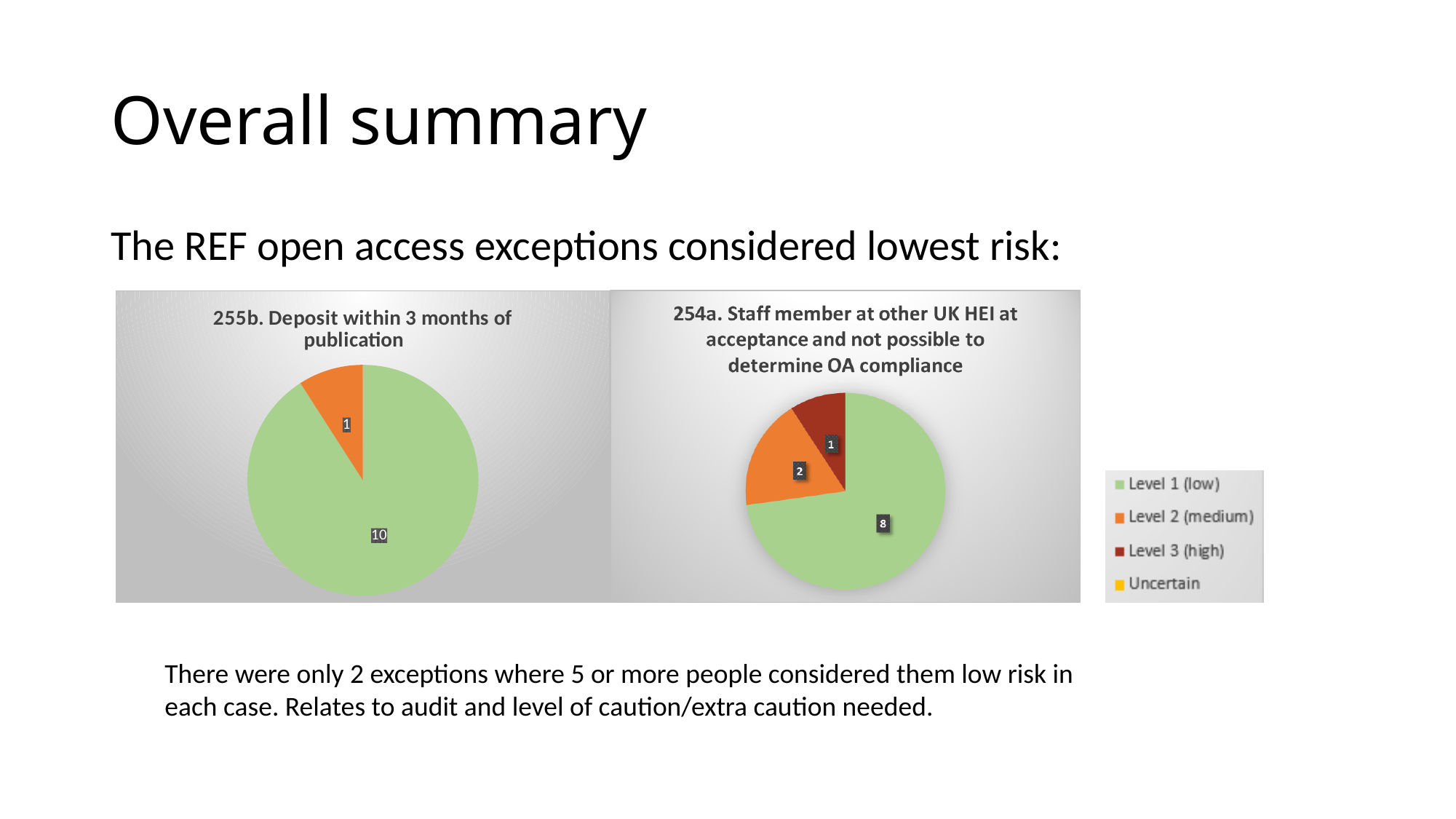
What kind of chart is used for "255b. Deposit within 3 months of publication"? Pie chart In the chart titled "255b. Deposit within 3 months of publication", what is the value for Level 2 (medium)? 1 In the chart titled "254a. Staff member at other UK HEI at acceptance and not possible to determine OA compliance", what is the value for Level 3 (high)? 1 Which chart has the larger Level 2 (medium) value, the left-hand chart (255b) or the right-hand chart (254a)? The right-hand chart (254a) In the chart titled "254a. Staff member at other UK HEI at acceptance and not possible to determine OA compliance", what is the value for Level 2 (medium)? 2 In the right-hand chart (254a), which risk level has the largest slice? Level 1 (low) In the chart titled "254a. Staff member at other UK HEI at acceptance and not possible to determine OA compliance", what is the value for Level 1 (low)? 8 In the left-hand chart (255b), what is the difference between the Level 1 (low) value and the Level 2 (medium) value? 9 In the right-hand chart (254a), which risk level has the smallest slice? Level 3 (high) How many entries does the shared legend list? 4 In the chart titled "255b. Deposit within 3 months of publication", what is the value for Level 1 (low)? 10 In the right-hand chart (254a), what is the total of all the slices shown? 11